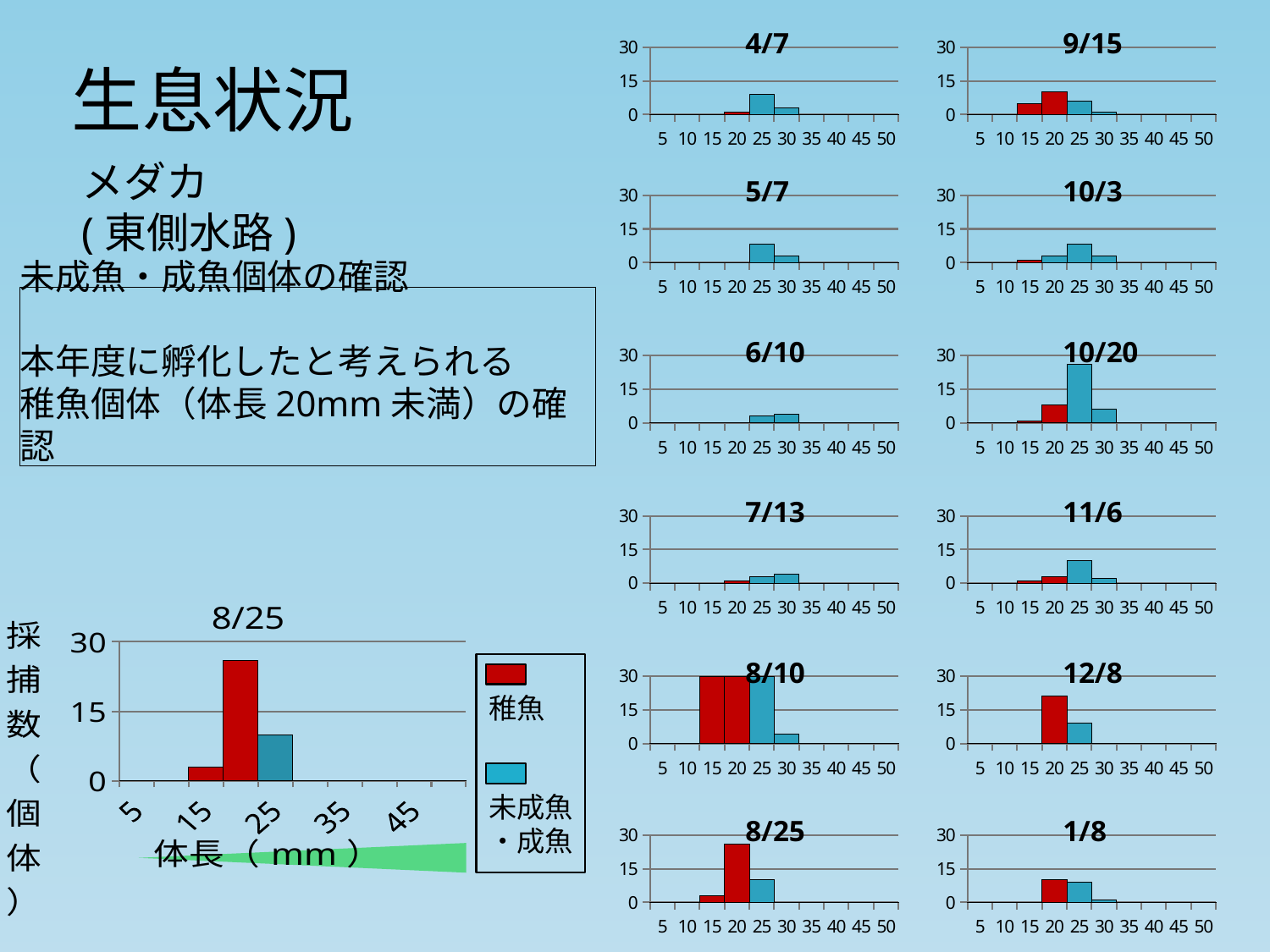
In the large 8/25 chart, is the value for the 25 mm class greater or less than 15? less In the large 8/25 chart, is the value for the 20 mm class greater or less than 15? greater How many small dated charts are shown on the right side of the slide? 12 How many series does the legend next to the large 8/25 chart list? 2 In the 4/7 chart, is the value for the 25 mm class greater or less than 15? less What kind of chart is the large 8/25 chart at the bottom left of the slide? bar chart In the large 8/25 chart, which is larger, the bar at 20 mm or the bar at 25 mm? 20 mm In the legend next to the large 8/25 chart, which colour represents 稚魚? red In the large 8/25 chart, which body-length class has the highest catch count? 20 What is the x-axis label of the large 8/25 chart? 体長（mm） In the 12/8 chart, which is larger, the bar at 20 mm or the bar at 25 mm? 20 mm